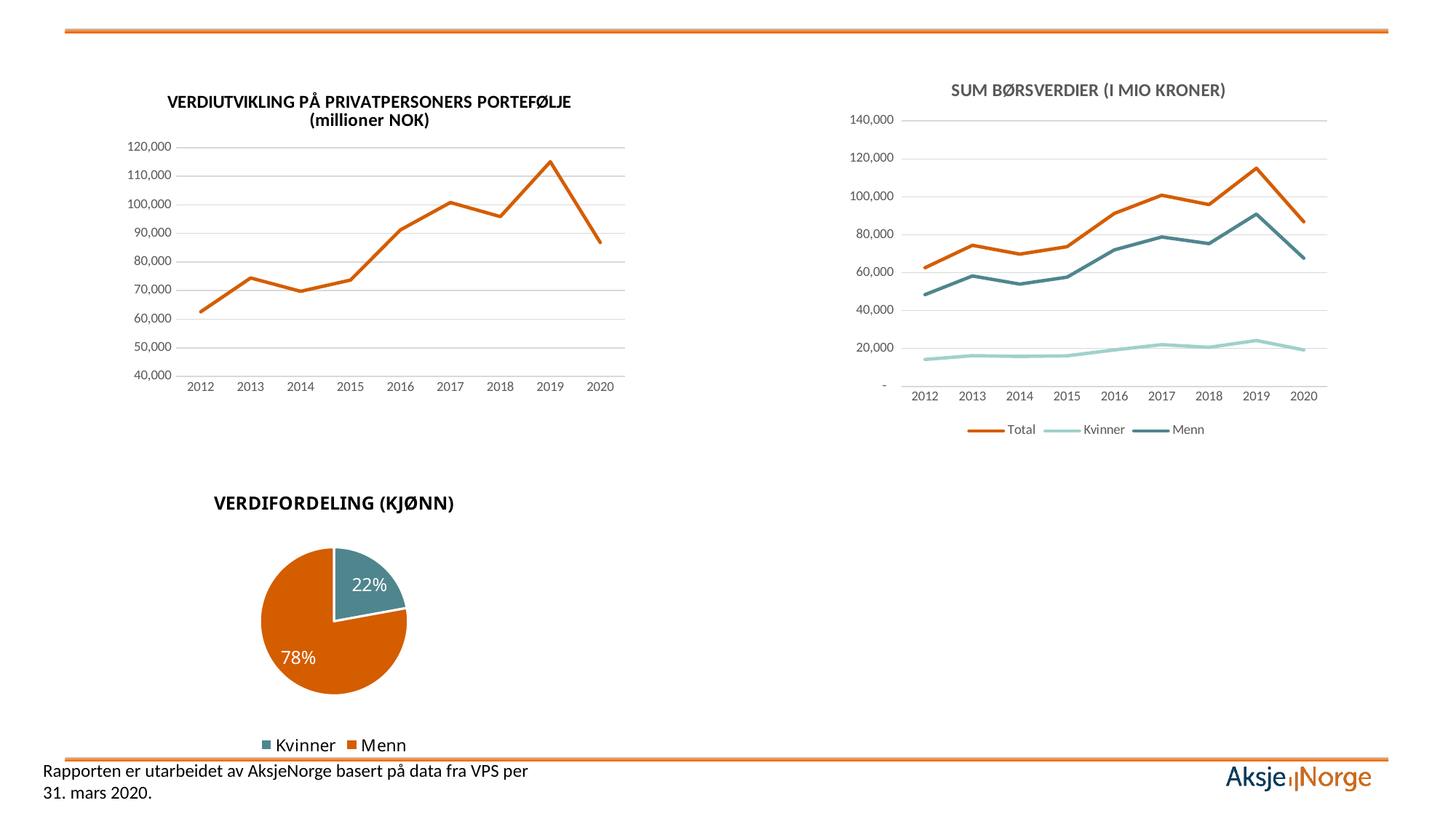
In the 'VERDIUTVIKLING PÅ PRIVATPERSONERS PORTEFØLJE' chart, is the value for 2020 higher or lower than the value for 2019? lower In the 'VERDIUTVIKLING PÅ PRIVATPERSONERS PORTEFØLJE' chart, is the value for 2019 greater or less than 110,000? greater In the 'VERDIUTVIKLING PÅ PRIVATPERSONERS PORTEFØLJE' chart, which year has the lowest value? 2012 In the 'VERDIUTVIKLING PÅ PRIVATPERSONERS PORTEFØLJE' chart, which year has the highest value? 2019 What kind of chart is the 'VERDIUTVIKLING PÅ PRIVATPERSONERS PORTEFØLJE' chart? line chart In the 'SUM BØRSVERDIER (I MIO KRONER)' chart, which series has the lowest values throughout? Kvinner How many years are shown on the x axis of the 'VERDIUTVIKLING PÅ PRIVATPERSONERS PORTEFØLJE' chart? 9 In the 'SUM BØRSVERDIER (I MIO KRONER)' chart, is the Menn value for 2012 greater or less than 60,000? less In the 'SUM BØRSVERDIER (I MIO KRONER)' chart, is the Kvinner value for 2019 greater or less than 20,000? greater In the 'VERDIFORDELING (KJØNN)' pie chart, what share is Menn? 78% How many series does the legend of the 'SUM BØRSVERDIER (I MIO KRONER)' chart list? 3 In the 'VERDIFORDELING (KJØNN)' pie chart, what share is Kvinner? 22%